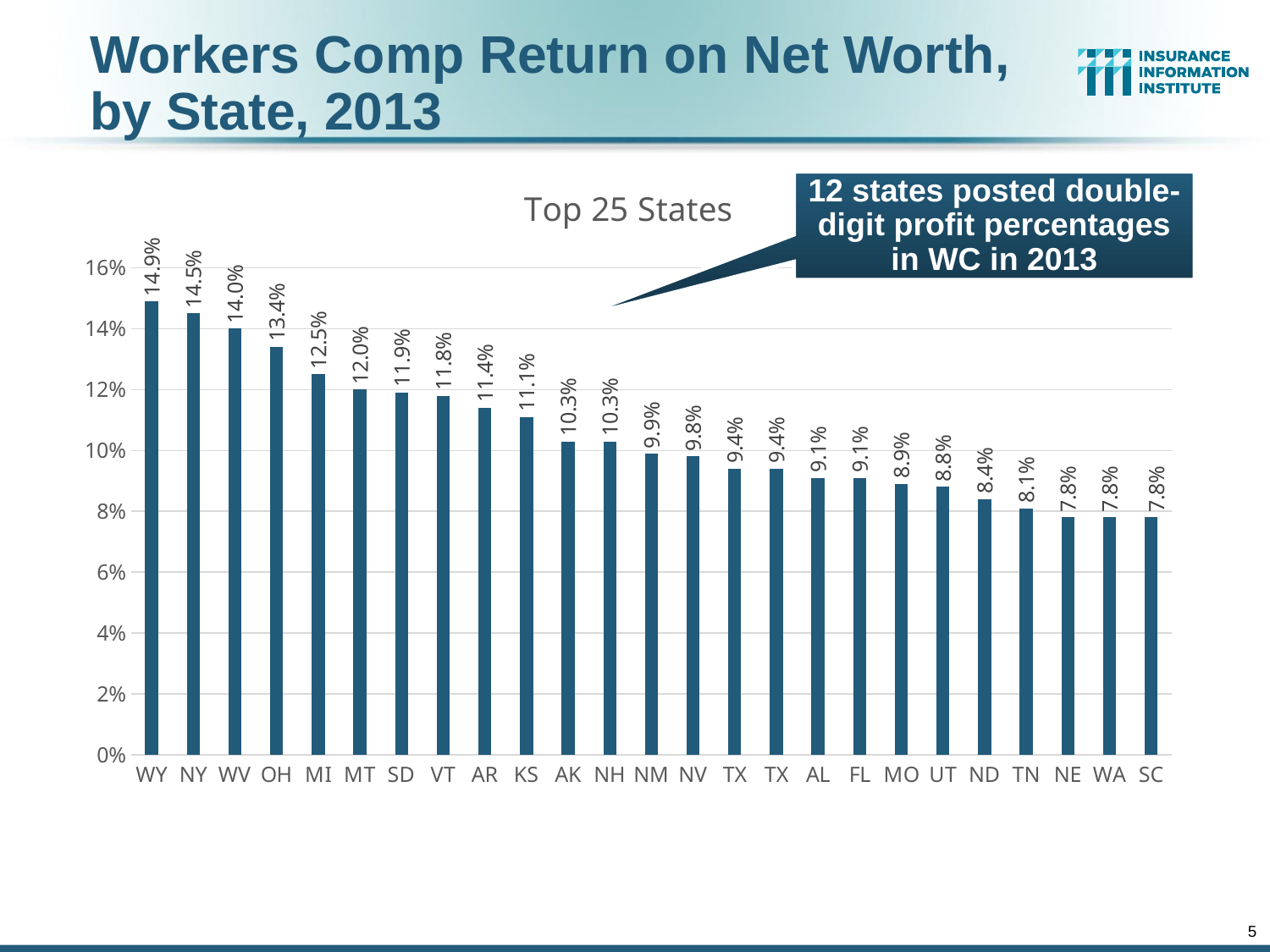
What is the workers comp return on net worth for WY? 14.9% What is the difference between the values for NY and WV? 0.5% What is the value shown for OH? 13.4% Which is larger, the value for ND or the value for UT? UT Which is larger, the value for VT or the value for AR? VT What kind of chart is shown on the slide? Bar chart What is the difference between the values for MI and KS? 1.4% How many states are shown in the chart? 25 Which state has the highest return on net worth in the chart? WY Do the values rise or fall moving from left to right along the x axis? Fall What is the value shown for MO? 8.9% Is the value for NM greater or less than 10%? less